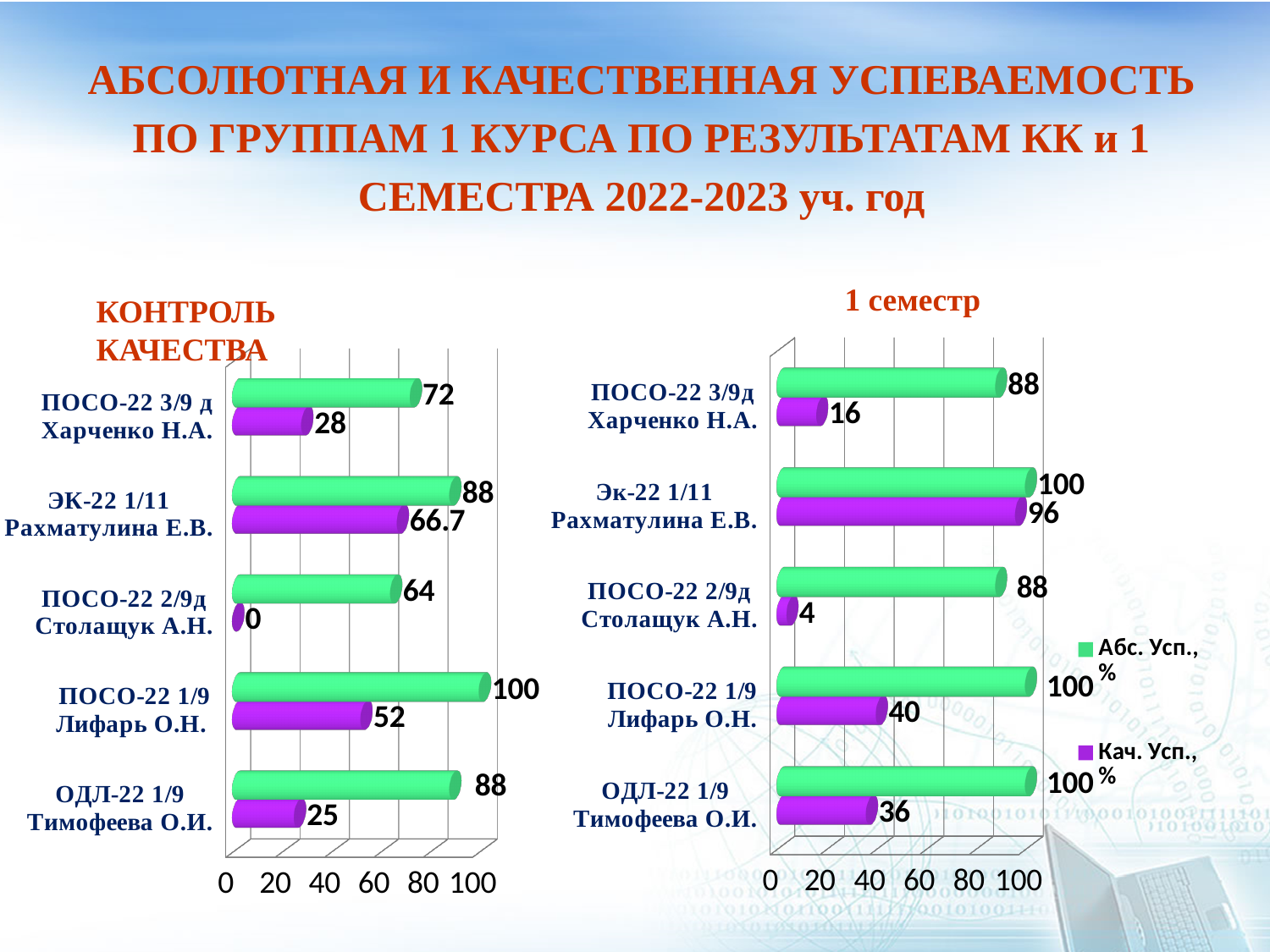
How many series does the legend of the 1 семестр chart list? 2 In the КОНТРОЛЬ КАЧЕСТВА chart, which group has the highest green-bar value? ПОСО-22 1/9 Лифарь О.Н. In the 1 семестр chart, is the Кач. Усп., % value larger for ПОСО-22 1/9 Лифарь О.Н. or for ОДЛ-22 1/9 Тимофеева О.И.? ПОСО-22 1/9 Лифарь О.Н. In the КОНТРОЛЬ КАЧЕСТВА chart, what is the value of the purple bar for ЭК-22 1/11 Рахматулина Е.В.? 66.7 In the 1 семестр chart, which group has the highest Кач. Усп., % value? Эк-22 1/11 Рахматулина Е.В. In the КОНТРОЛЬ КАЧЕСТВА chart, which group has the lowest purple-bar value? ПОСО-22 2/9д Столащук А.Н. In the 1 семестр chart, what is the Кач. Усп., % value for ПОСО-22 2/9д Столащук А.Н.? 4 In the 1 семестр chart, what is the difference between the Абс. Усп., % and Кач. Усп., % values for ПОСО-22 3/9д Харченко Н.А.? 72 How many groups are shown in the 1 семестр chart? 5 In the 1 семестр chart, what is the Абс. Усп., % value for ПОСО-22 3/9д Харченко Н.А.? 88 In the КОНТРОЛЬ КАЧЕСТВА chart, what is the value of the green bar for ПОСО-22 3/9 д Харченко Н.А.? 72 In the КОНТРОЛЬ КАЧЕСТВА chart, what is the difference between the green and purple bars for ПОСО-22 1/9 Лифарь О.Н.? 48